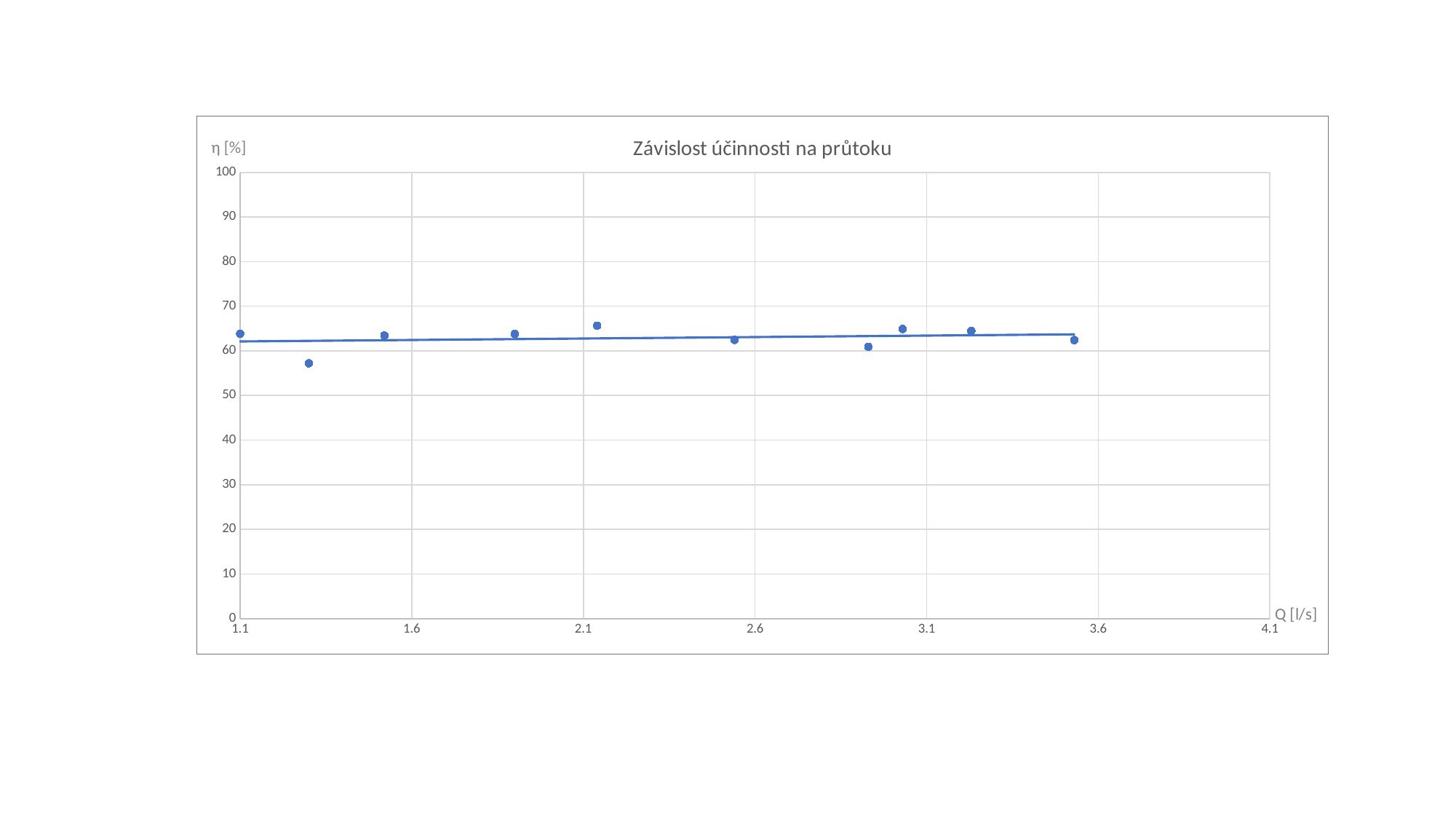
What kind of chart is shown on the slide? scatter chart Is the value of the last point near Q = 3.5 greater or less than 70? less What is the label of the vertical axis? η [%] How many data points are plotted on the chart? 10 Is the lowest plotted point greater or less than 60? less Is the value of the first point at Q = 1.1 greater or less than 60? greater What is the maximum value shown on the vertical axis? 100 Does the trendline rise or fall as Q increases? rises slightly Which point has the lowest efficiency value: the one near Q = 1.3 or the one near Q = 2.1? the one near Q = 1.3 What is the title of the chart? Závislost účinnosti na průtoku